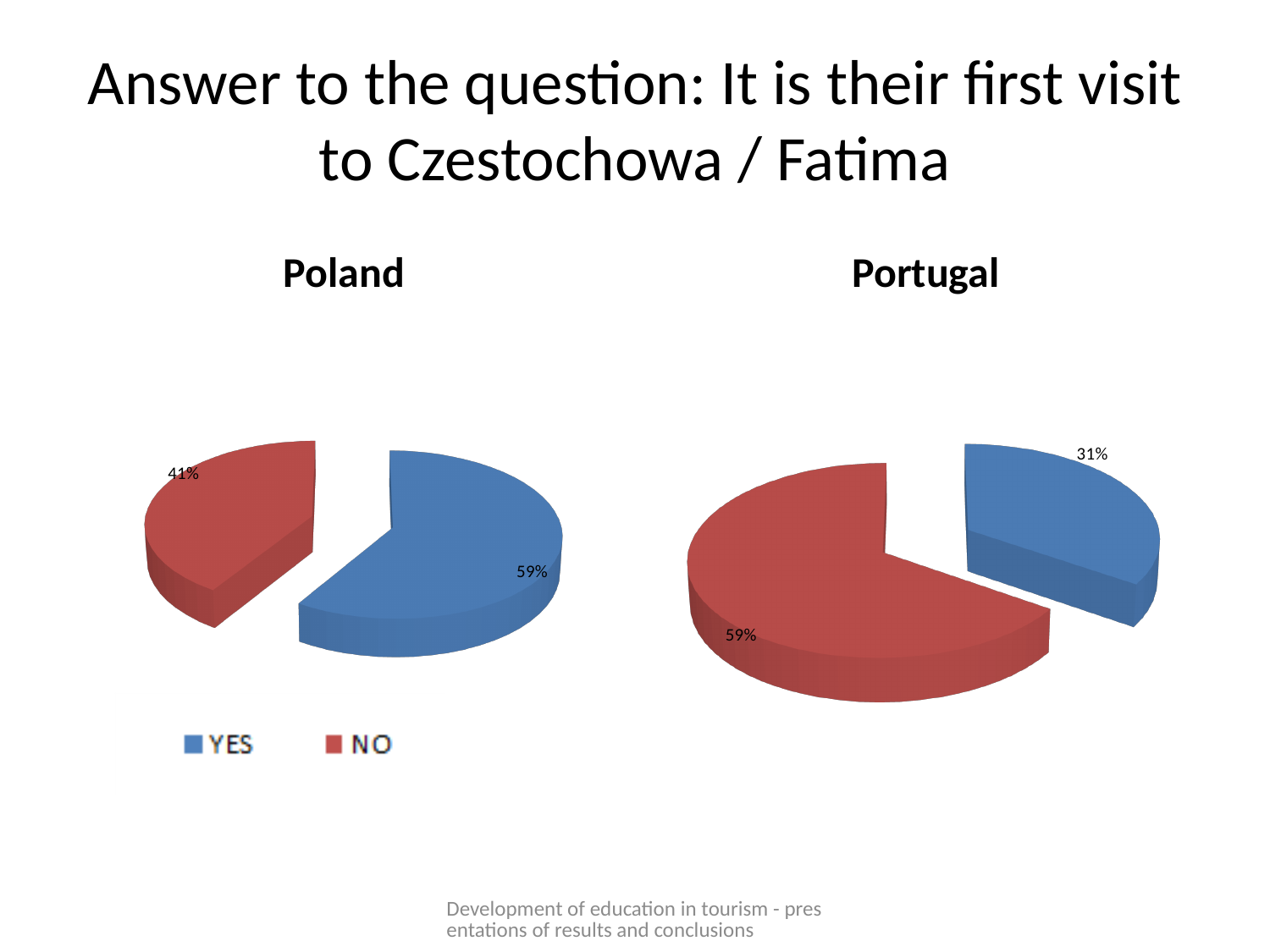
In the Portugal chart, which answer has the smaller share? YES In the Portugal chart, what is the difference between the NO and YES percentages? 28% In the Poland chart, which answer has the larger share? YES What kind of chart is used for Poland and Portugal on this slide? Pie chart In the Portugal chart, what percentage answered YES? 31% Which colour represents NO in the charts? Red In the Poland chart, what percentage answered YES? 59% In the Portugal chart, what percentage answered NO? 59% How many entries does the legend list? 2 Is the YES share larger in the Poland chart or the Portugal chart? Poland In the Poland chart, what is the difference between the YES and NO percentages? 18% In the Poland chart, what percentage answered NO? 41%